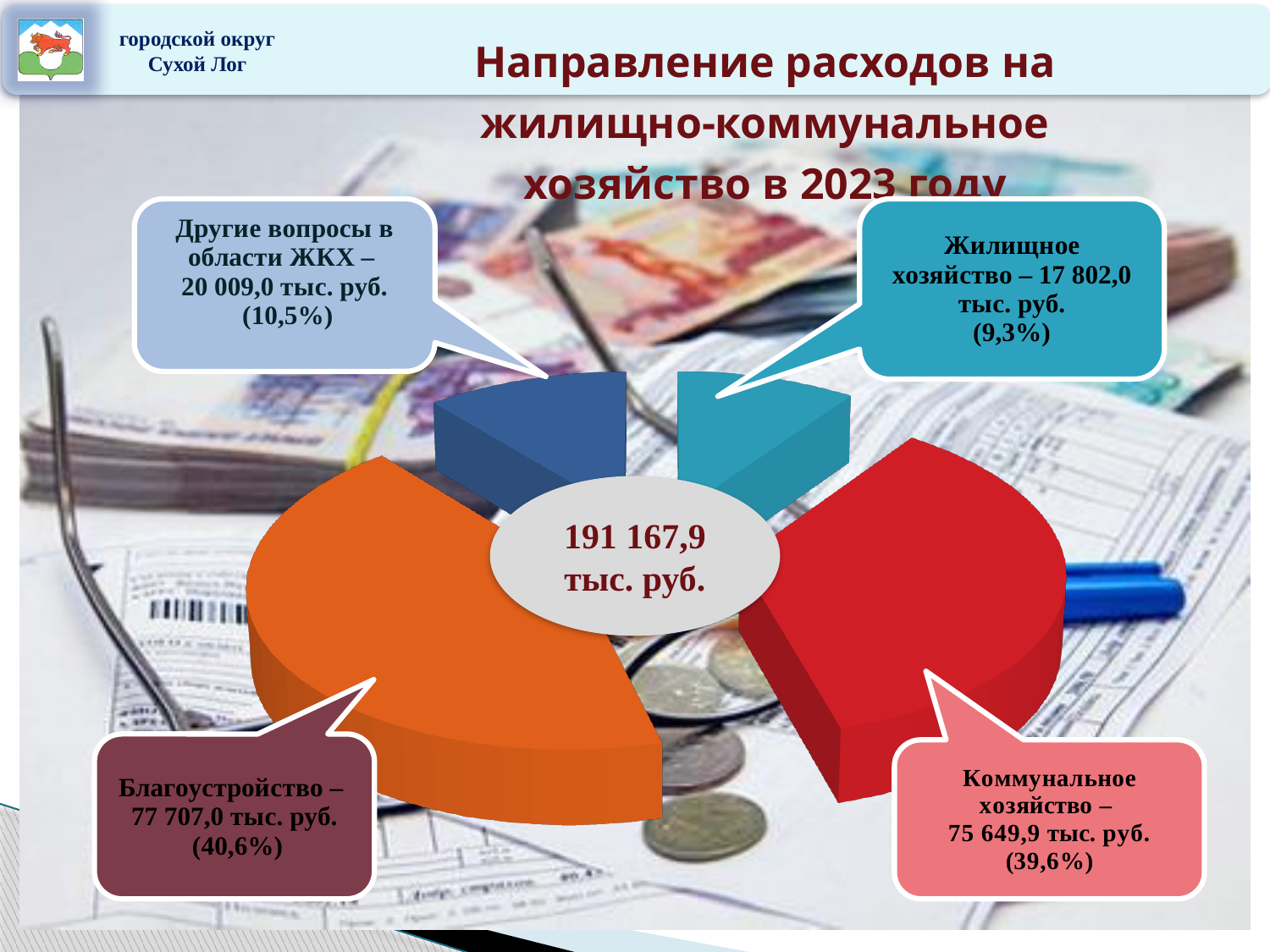
What share of the pie does Другие вопросы в области ЖКХ represent? 10,5% What is the difference between Благоустройство and Коммунальное хозяйство? 2 057,1 тыс. руб. Which is larger, Другие вопросы в области ЖКХ or Жилищное хозяйство? Другие вопросы в области ЖКХ Which category has the largest value? Благоустройство Which category has the smallest value? Жилищное хозяйство What is the total amount shown in the centre of the pie chart? 191 167,9 тыс. руб. How many slices does the pie chart have? 4 What kind of chart is shown on the slide? pie chart What is the value for Благоустройство? 77 707,0 тыс. руб. What share of the pie does Коммунальное хозяйство represent? 39,6% What is the value for Коммунальное хозяйство? 75 649,9 тыс. руб. What is the value for Жилищное хозяйство? 17 802,0 тыс. руб.